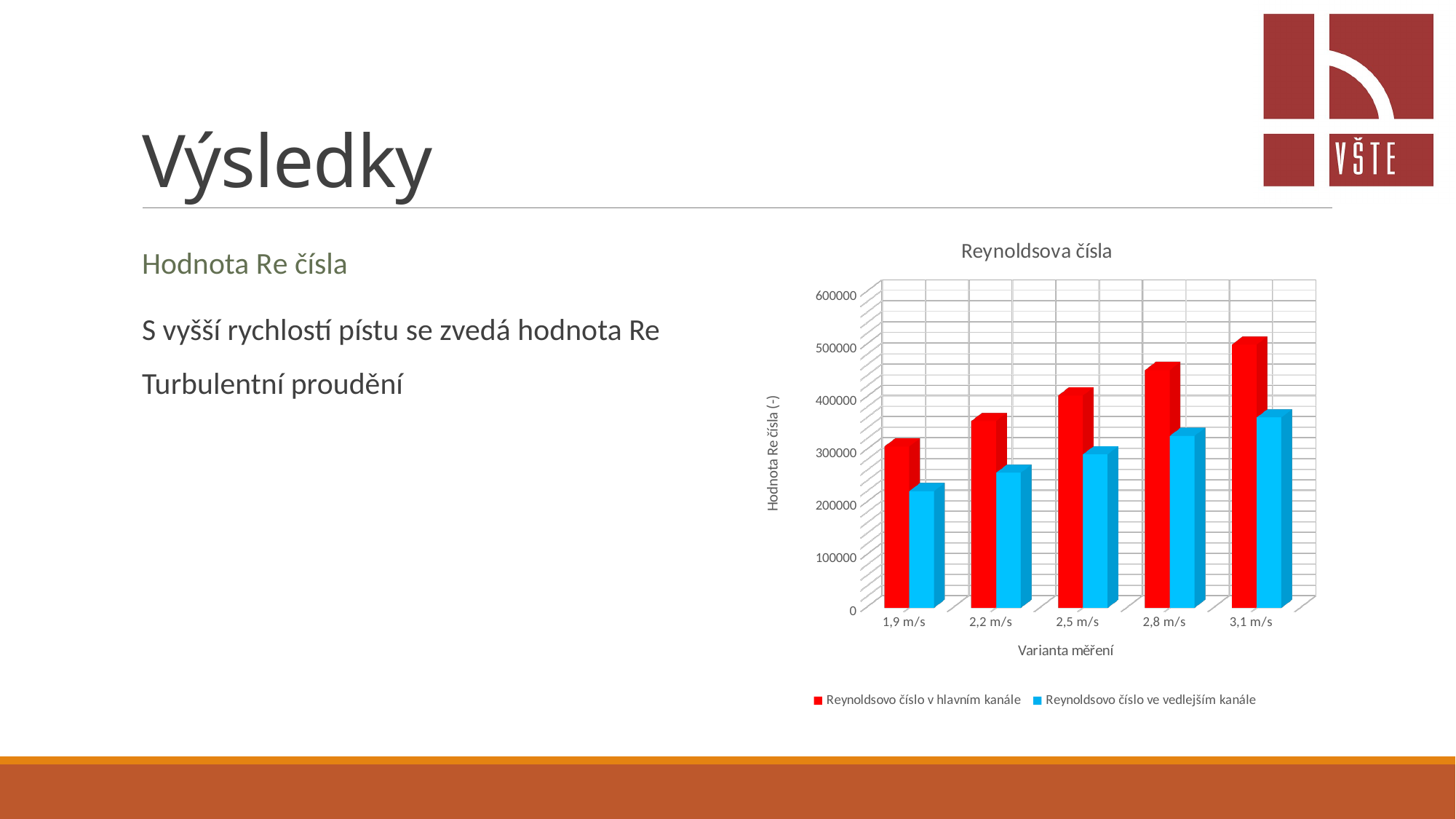
What type of chart is shown on the slide? bar chart Do the values for Reynoldsovo číslo v hlavním kanále rise or fall as the speed increases along the x axis? rise What is the label of the vertical axis of the chart? Hodnota Re čísla (-) Is the value for Reynoldsovo číslo ve vedlejším kanále at 1,9 m/s greater or less than 300000? less At 2,5 m/s, which series has the larger value: Reynoldsovo číslo v hlavním kanále or Reynoldsovo číslo ve vedlejším kanále? Reynoldsovo číslo v hlavním kanále How many categories are shown on the x axis of the chart? 5 Is the value for Reynoldsovo číslo v hlavním kanále at 3,1 m/s greater or less than 400000? greater What is the title of the chart? Reynoldsova čísla Which category has the highest value for Reynoldsovo číslo v hlavním kanále? 3,1 m/s How many series does the chart legend list? 2 Is the value for Reynoldsovo číslo ve vedlejším kanále at 3,1 m/s greater or less than 400000? less Which category has the lowest value for Reynoldsovo číslo ve vedlejším kanále? 1,9 m/s